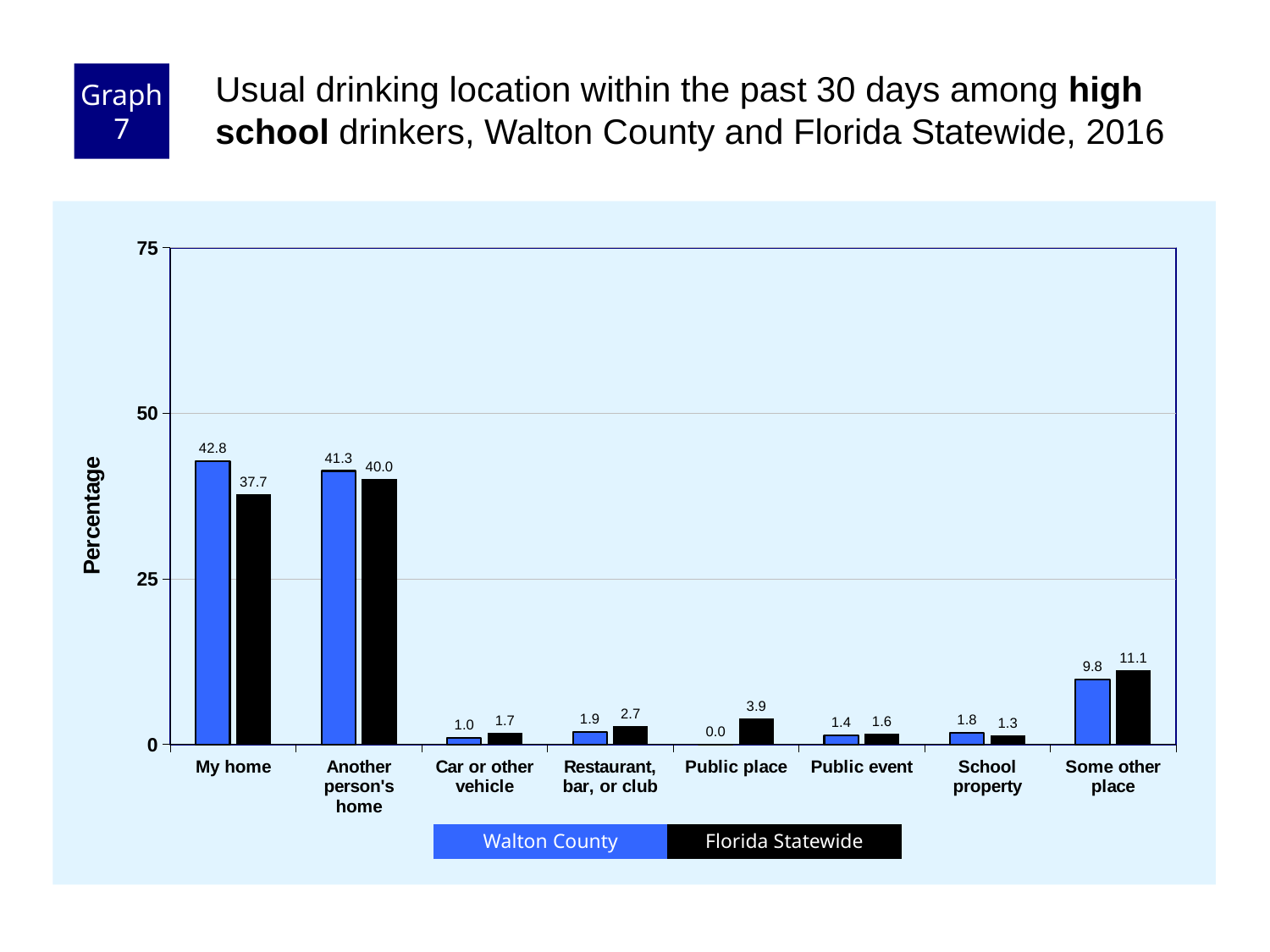
Which is larger for "Restaurant, bar, or club": Walton County or Florida Statewide? Florida Statewide How many location categories are shown on the x axis? 8 Which category has the lowest Florida Statewide value? School property What is the Walton County value for "Public place"? 0.0 How many series does the legend list? 2 What is the Walton County value for "My home"? 42.8 What is the label of the y axis? Percentage What is the difference between the Walton County and Florida Statewide values for "My home"? 5.1 Which category has the highest Walton County value? My home Is the Florida Statewide value for "Another person's home" greater or less than 25? greater What is the Florida Statewide value for "Some other place"? 11.1 What kind of chart is shown on the slide? Bar chart